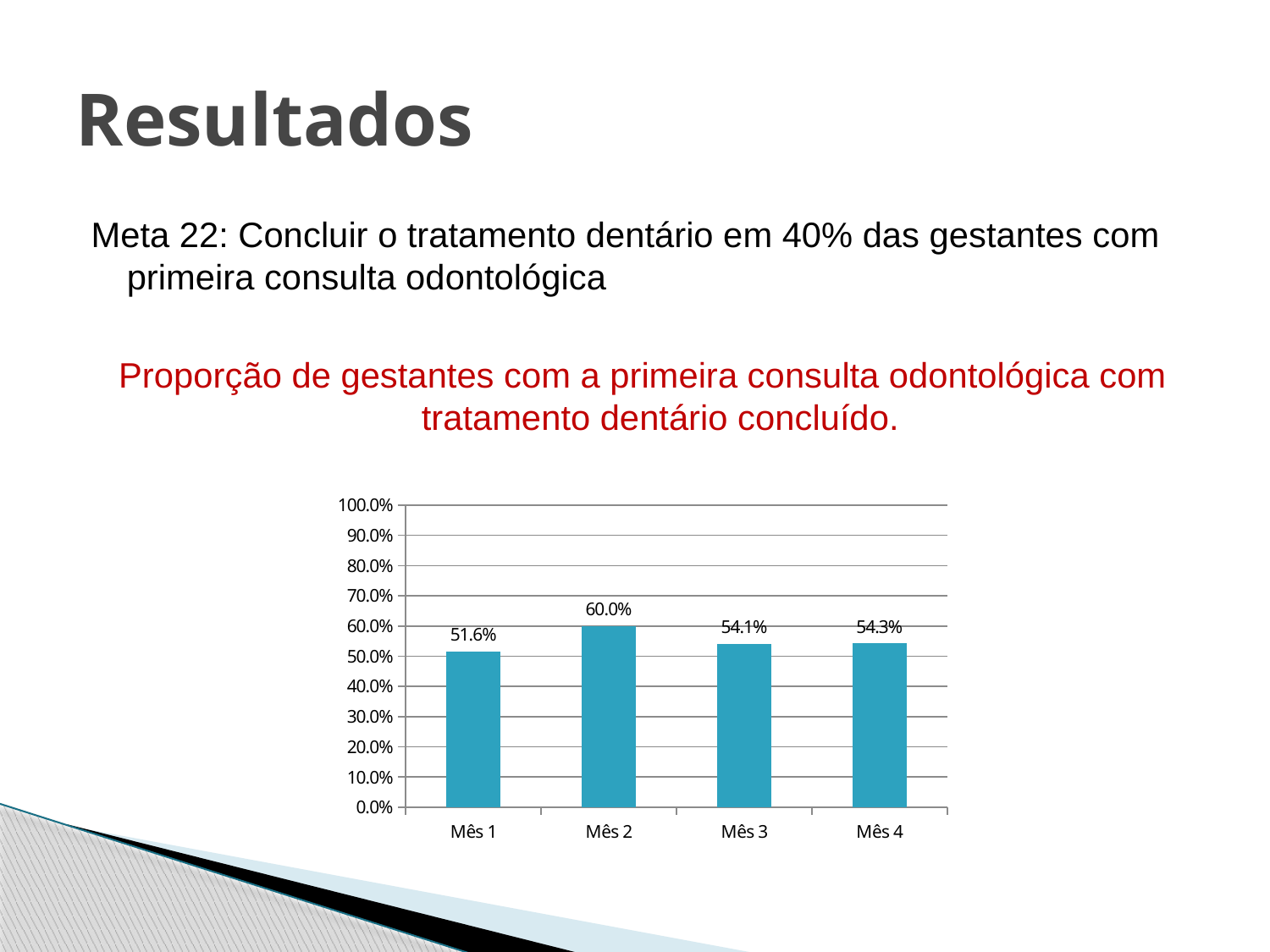
What is the highest value shown on the y axis? 100.0% What is the value for Mês 2? 60.0% Is the value for Mês 1 greater or less than 40.0%? greater Which month has the highest value? Mês 2 What is the value for Mês 3? 54.1% Which month has the lowest value? Mês 1 What is the value for Mês 4? 54.3% How many months are shown on the x axis? 4 What kind of chart is shown on the slide? bar chart Which is larger, the value for Mês 2 or the value for Mês 3? Mês 2 What is the value for Mês 1? 51.6% What is the difference between the values for Mês 2 and Mês 1? 8.4%